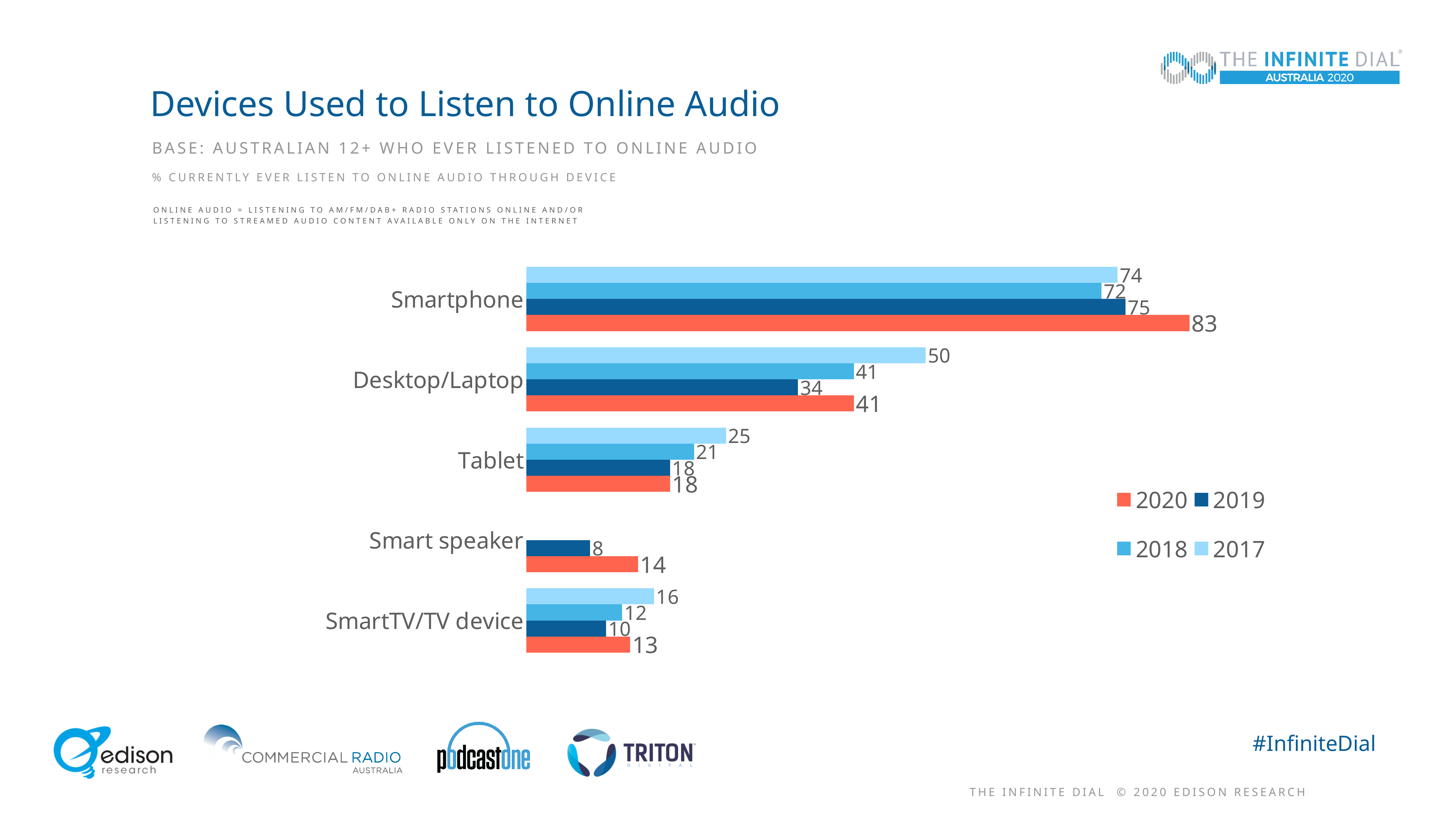
How many device categories are shown on the chart? 5 Which device has the highest 2020 value? Smartphone What is the difference between the 2020 and 2019 values for Smartphone? 8 Which colour represents the 2020 series in the legend? Red/orange What is the 2018 value for SmartTV/TV device? 12 What is the 2020 value for Smartphone? 83 Which device has the lowest 2019 value? Smart speaker How many series does the legend list? 4 What is the 2017 value for Desktop/Laptop? 50 What is the 2019 value for Smart speaker? 8 What kind of chart is shown on the slide? Bar chart Which is larger for Desktop/Laptop: the 2017 value or the 2019 value? 2017